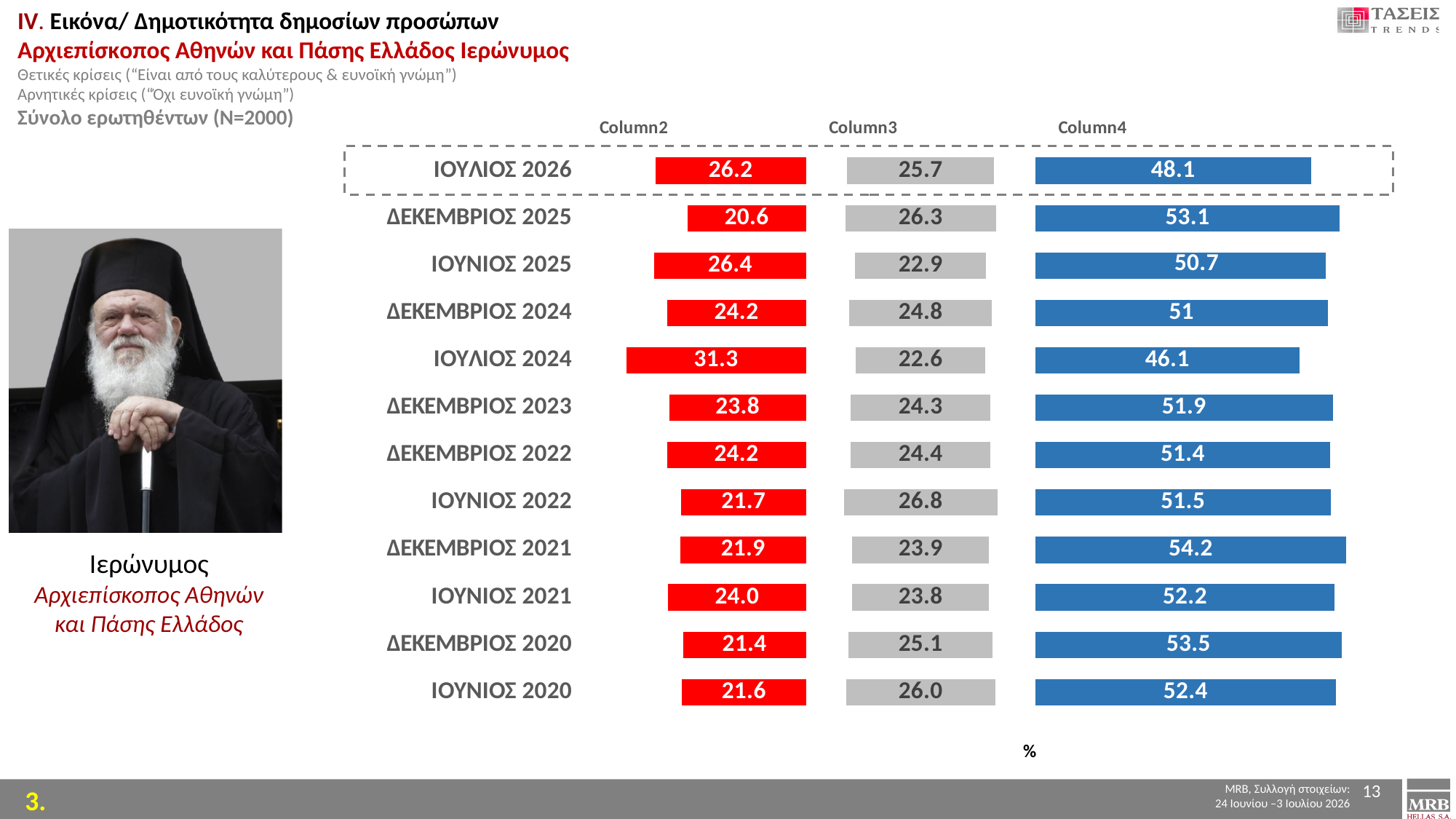
What is the Column4 value for ΔΕΚΕΜΒΡΙΟΣ 2021? 54.2 What is the Column3 value for ΙΟΥΝΙΟΣ 2020? 26.0 What is the Column2 value for ΙΟΥΛΙΟΣ 2026? 26.2 In which period is the Column2 value lowest? ΔΕΚΕΜΒΡΙΟΣ 2025 In which period is the Column2 value highest? ΙΟΥΛΙΟΣ 2024 What is the difference between the Column4 values for ΔΕΚΕΜΒΡΙΟΣ 2025 and ΙΟΥΛΙΟΣ 2026? 5.0 Which is larger: the Column3 value for ΙΟΥΝΙΟΣ 2022 or for ΙΟΥΝΙΟΣ 2025? ΙΟΥΝΙΟΣ 2022 What kind of chart is shown on the slide? bar chart In which period is the Column4 value lowest? ΙΟΥΛΙΟΣ 2024 What colour are the Column4 bars? blue How many series does the chart legend list? 3 How many time periods (categories) are shown in the chart? 12